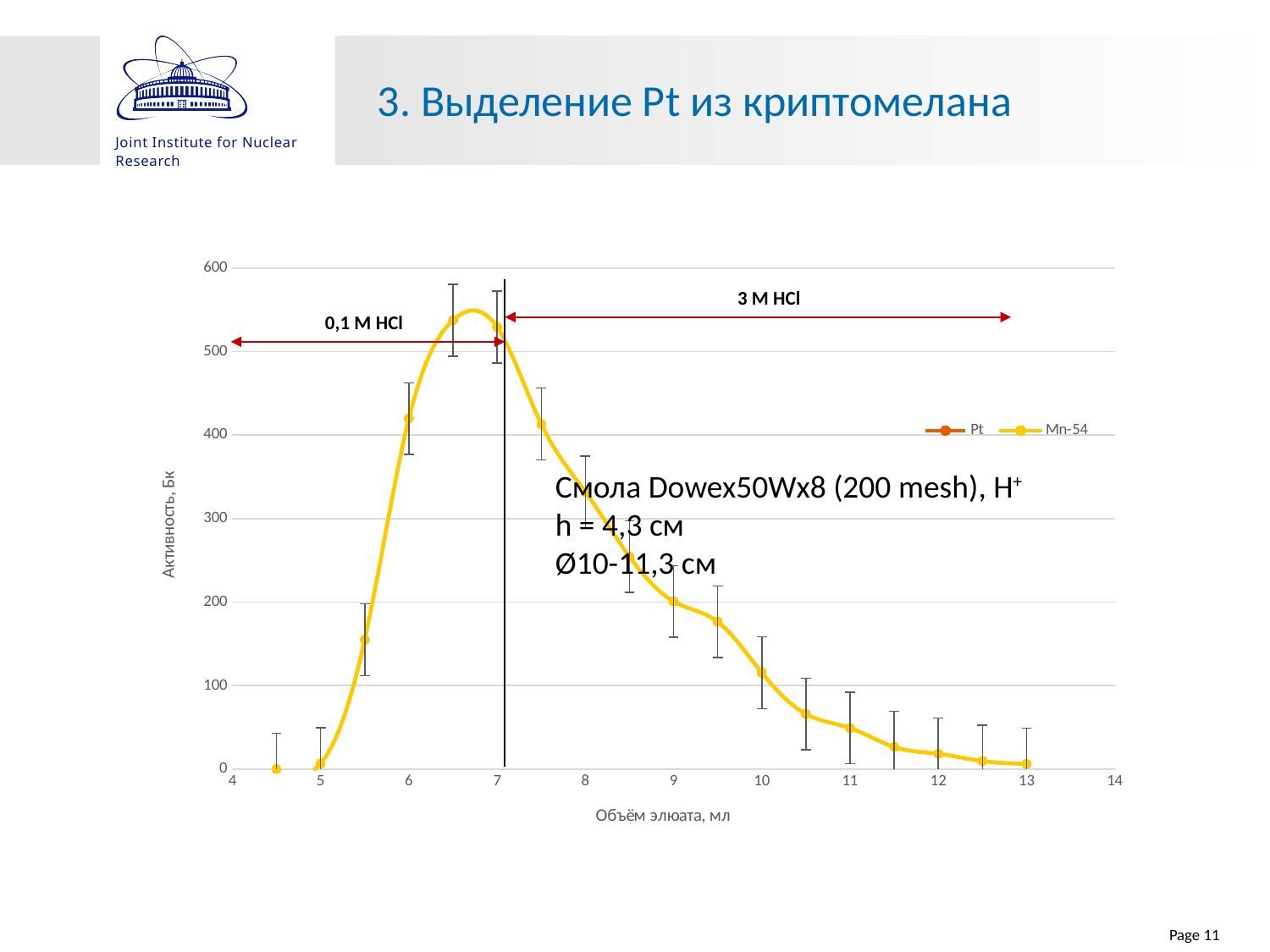
What are the two series named in the chart legend? Pt and Mn-54 How many series does the chart legend list? 2 Which has the higher Mn-54 activity: an eluate volume of 6 ml or 10 ml? 6 ml Is the Mn-54 activity at an eluate volume of 10 ml greater or less than 200? less What is the title of the x axis of the chart? Объём элюата, мл Is the Mn-54 activity at an eluate volume of 13 ml greater or less than 100? less What kind of chart is shown on the slide? Line chart Is the Mn-54 activity at an eluate volume of 6.5 ml greater or less than 500? greater How many data points are plotted for the Mn-54 series? 18 Do the Mn-54 activity values rise or fall as the eluate volume increases from 7 ml to 13 ml? fall